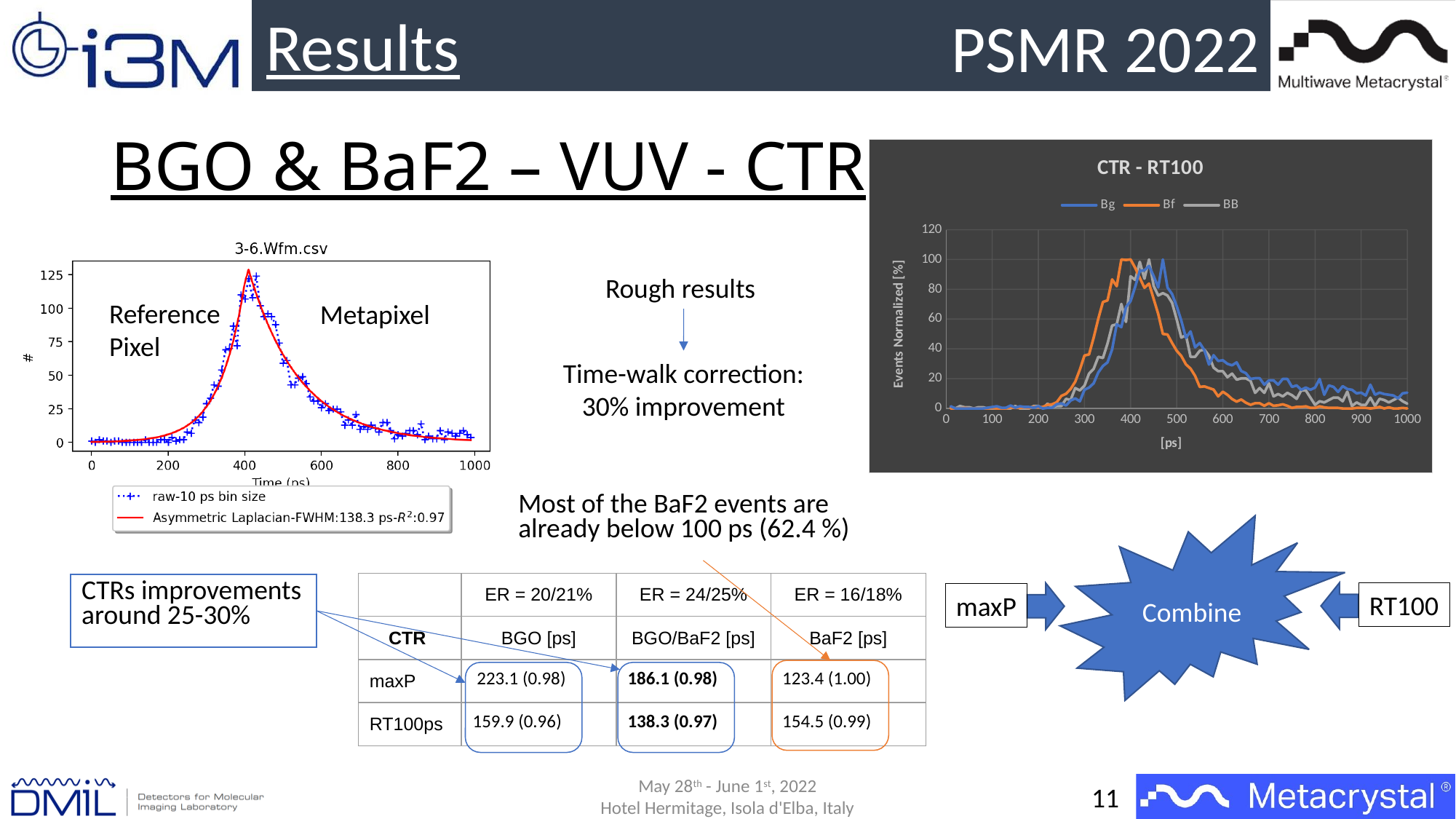
In the CTR - RT100 chart, which series reaches its peak at the smallest value on the x axis? Bf In the CTR - RT100 chart, is the value of the Bg series at 600 ps greater or less than 20? greater What is the y-axis label of the CTR - RT100 chart? Events Normalized [%] How many series does the legend of the CTR - RT100 chart list? 3 What are the legend entries of the CTR - RT100 chart? Bg, Bf, BB In the CTR - RT100 chart, is the value of the Bf series at 600 ps greater or less than 20? less In the CTR - RT100 chart, do the values of the Bf series rise or fall between 500 ps and 1000 ps? fall What kind of chart is the CTR - RT100 chart? line chart In the 3-6.Wfm.csv chart, is the value at 800 ps greater or less than 25? less What is the title of the chart on the left side of the slide? 3-6.Wfm.csv